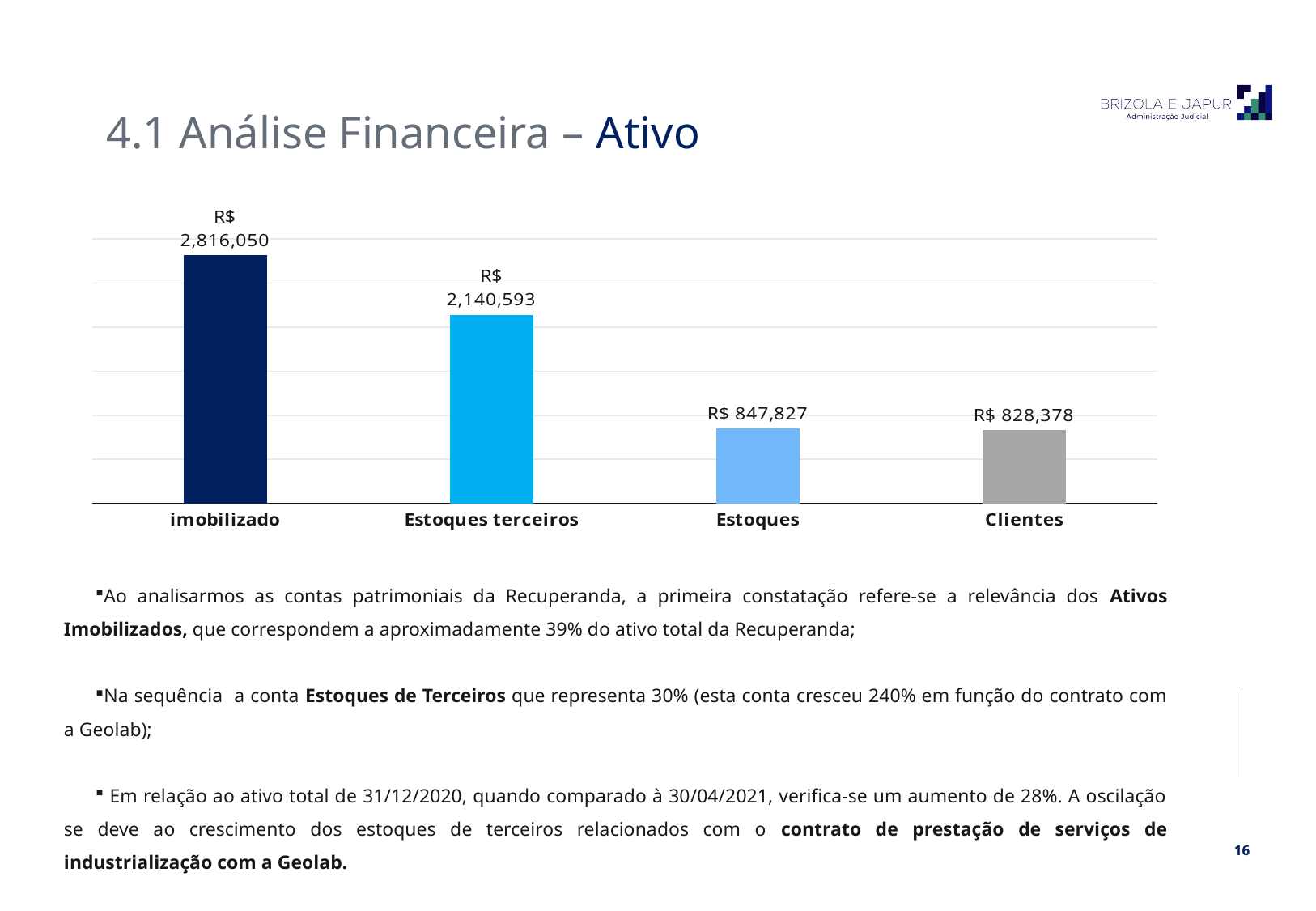
Which is larger, the value for Estoques terceiros or the value for Estoques? Estoques terceiros Which category has the highest value? imobilizado What is the difference between the values for imobilizado and Estoques terceiros? R$ 675,457 What is the value for Estoques? R$ 847,827 Do the values rise or fall from left to right across the categories? Fall What kind of chart is shown on the slide? Bar chart Which category has the lowest value? Clientes What is the value for imobilizado? R$ 2,816,050 What is the difference between the values for Estoques and Clientes? R$ 19,449 How many categories are shown in the chart? 4 What is the value for Estoques terceiros? R$ 2,140,593 What is the value for Clientes? R$ 828,378